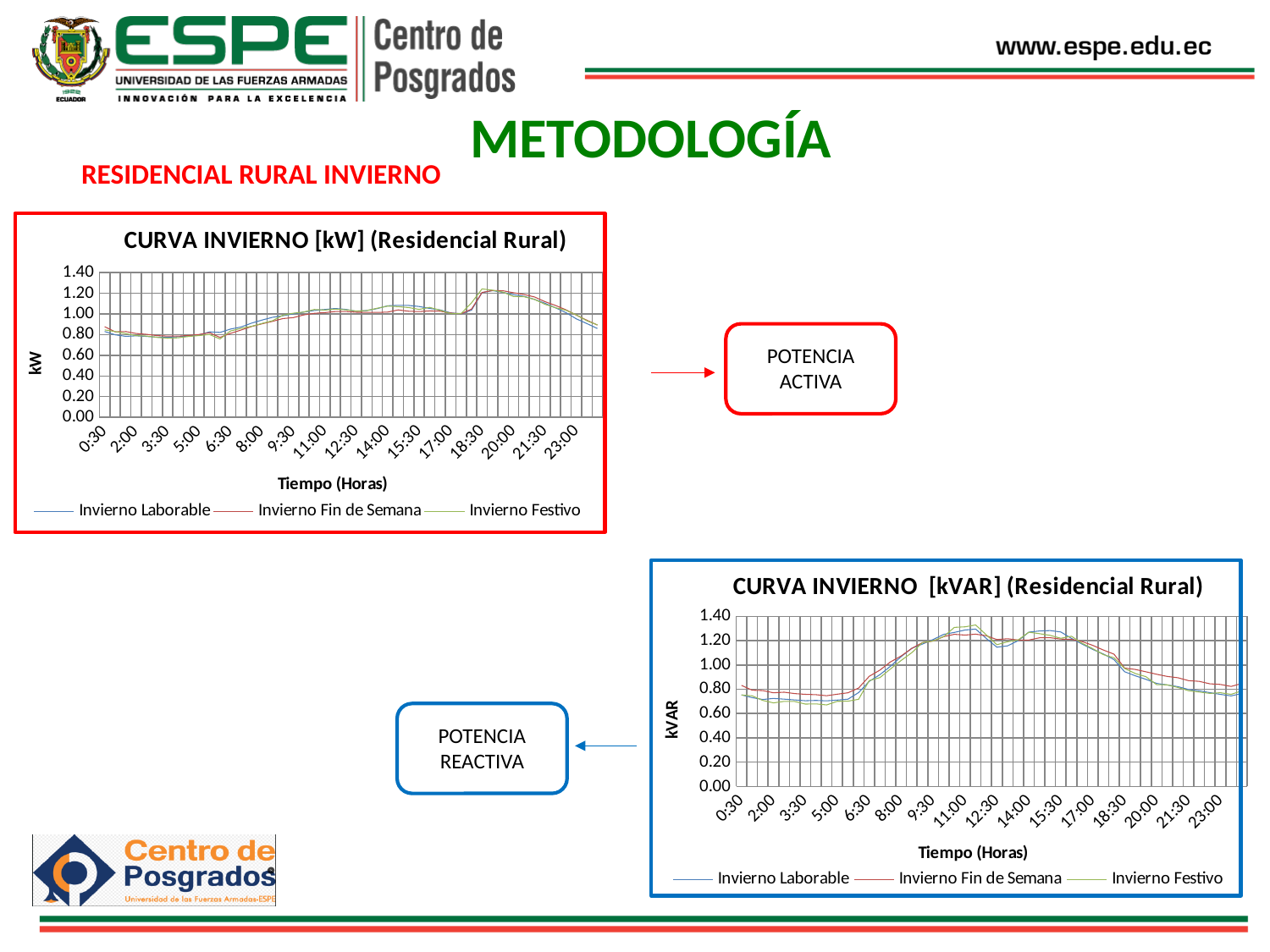
In the 'CURVA INVIERNO [kW] (Residencial Rural)' chart, do the values rise or fall between 20:00 and 23:00? fall What is the y-axis title of the 'CURVA INVIERNO [kVAR] (Residencial Rural)' chart? kVAR How many time labels are shown on the x axis of the 'CURVA INVIERNO [kVAR] (Residencial Rural)' chart? 16 In the 'CURVA INVIERNO [kW] (Residencial Rural)' chart, is the value of Invierno Laborable at 0:30 greater or less than 0.60? greater How many series does the legend of the 'CURVA INVIERNO [kW] (Residencial Rural)' chart list? 3 What are the legend entries of the 'CURVA INVIERNO [kVAR] (Residencial Rural)' chart? Invierno Laborable, Invierno Fin de Semana, Invierno Festivo In the 'CURVA INVIERNO [kW] (Residencial Rural)' chart, is the value of Invierno Festivo at 19:00 greater or less than 1.00? greater In the 'CURVA INVIERNO [kVAR] (Residencial Rural)' chart, do the values rise or fall between 5:00 and 11:00? rise What is the highest tick value shown on the y axis of the 'CURVA INVIERNO [kW] (Residencial Rural)' chart? 1.40 What kind of chart is the 'CURVA INVIERNO [kW] (Residencial Rural)' chart? line chart In the 'CURVA INVIERNO [kVAR] (Residencial Rural)' chart, is the value of Invierno Laborable at 3:30 greater or less than 0.80? less